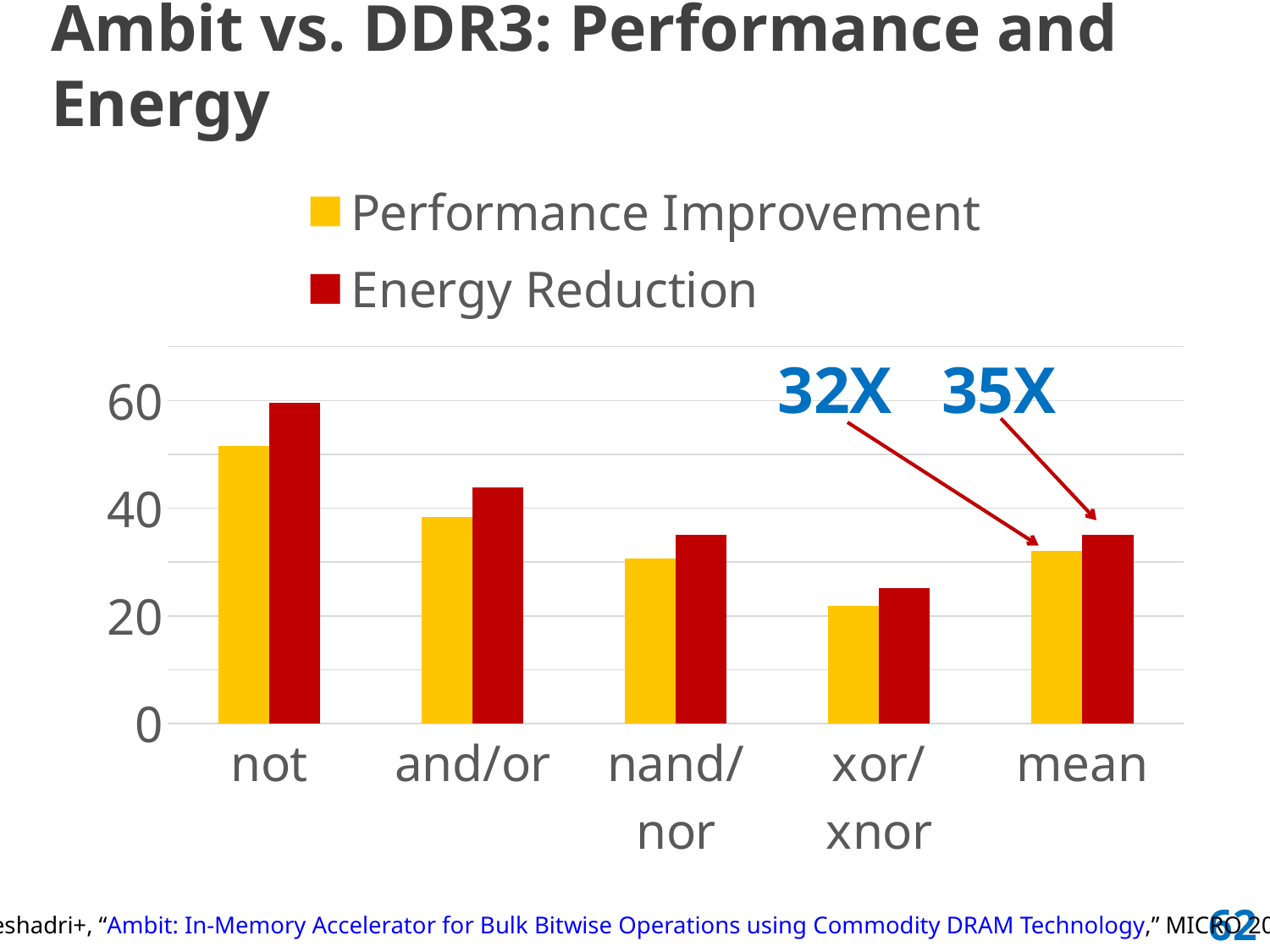
Which operation has the lowest Energy Reduction? xor/xnor For the mean category, which is larger: Performance Improvement or Energy Reduction? Energy Reduction Which operation has the highest Performance Improvement? not How many categories are shown on the x axis? 5 What is the Performance Improvement value for the mean category? 32X Does the Performance Improvement rise or fall from not to xor/xnor? fall What kind of chart is shown on the slide? bar chart What is the Energy Reduction value for the mean category? 35X Is the Energy Reduction value for nand/nor greater or less than 40? less How many series does the legend list? 2 Is the Energy Reduction value for not greater or less than 40? greater For the mean category, what is the difference between the Energy Reduction and Performance Improvement values? 3X